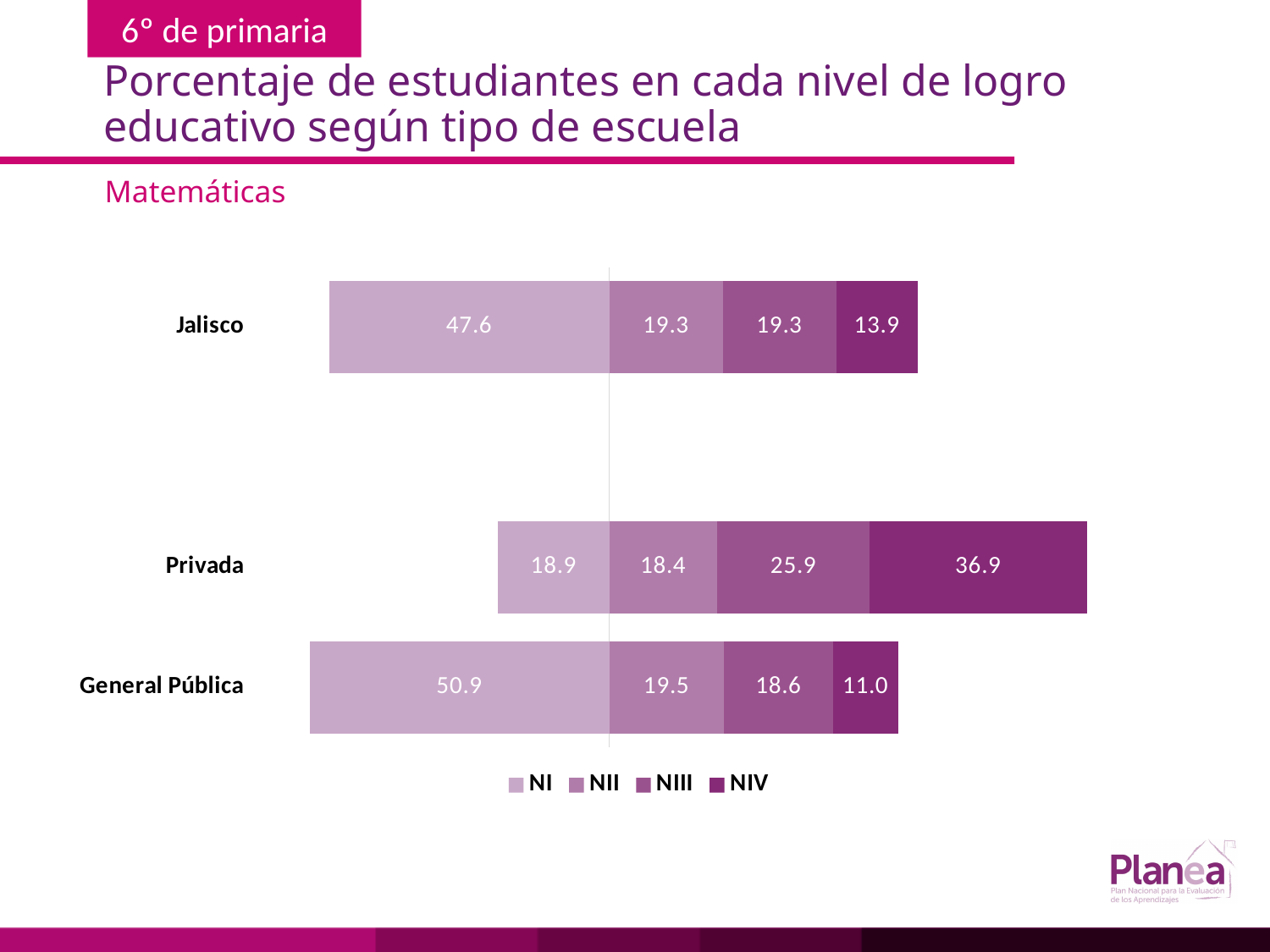
How many categories (school types) are shown on the chart? 3 How many series does the legend list? 4 Which is larger, the NIII value for Privada or the NIII value for Jalisco? Privada What is the total of the stacked bar for General Pública? 100.0 What is the NIII value for General Pública? 18.6 What is the NIV value for Privada? 36.9 What type of chart is shown on the slide? Stacked bar chart What subject is the chart about, according to the subtitle? Matemáticas What is the NI value for Jalisco? 47.6 What is the difference between the NIV values for Privada and Jalisco? 23.0 Which category has the lowest NIV value? General Pública Which category has the highest NI value? General Pública